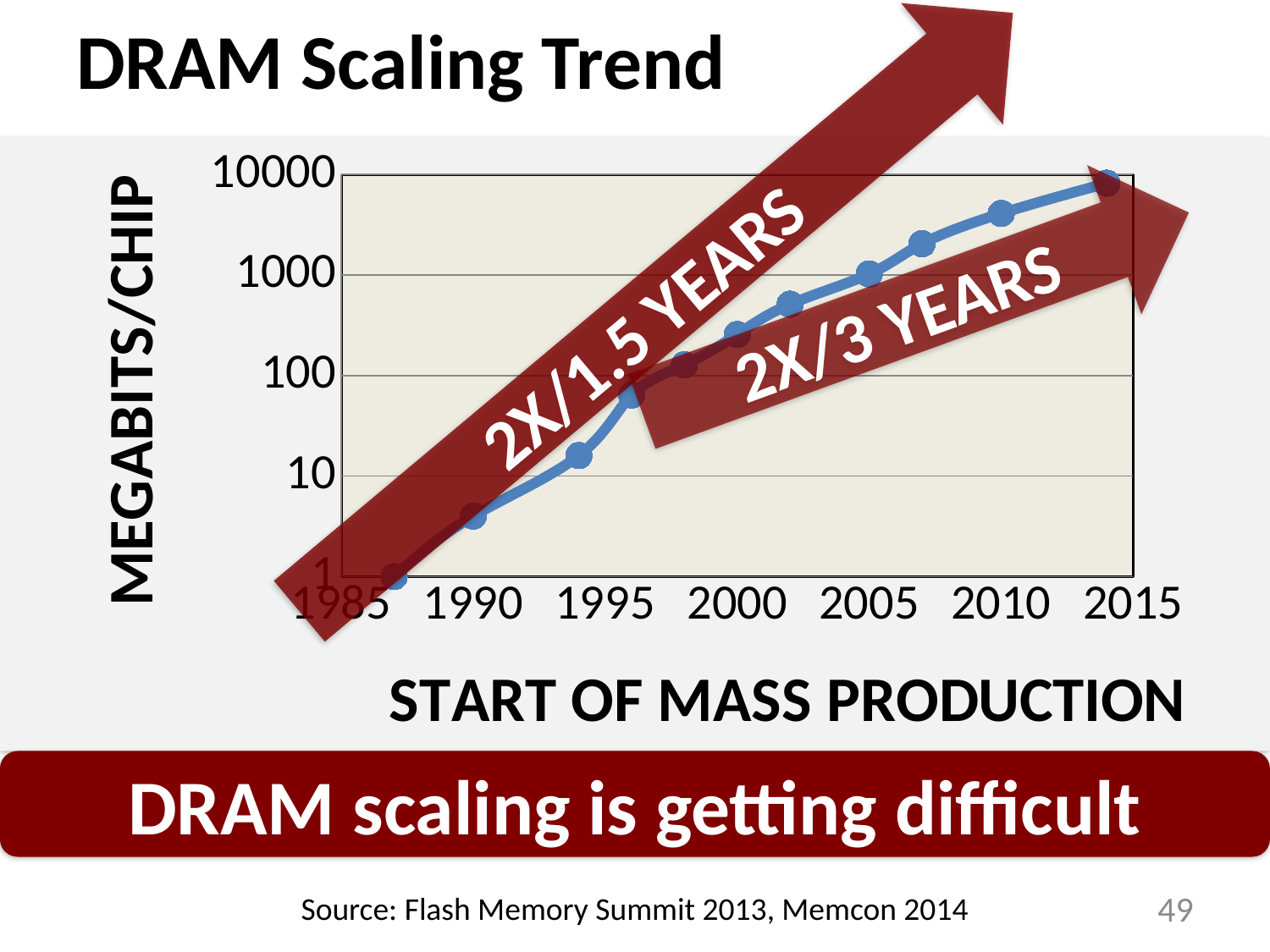
Is the value for the point at 2007 greater or less than 1000 megabits/chip? greater Is the value for the point at 1990 greater or less than 10 megabits/chip? less What is the title of the y axis? MEGABITS/CHIP Do the megabits per chip values rise or fall as the start of mass production year increases? rise Is the value for the point at 2000 greater or less than 100 megabits/chip? greater Which has the smaller megabits/chip value, the point at 2000 or the point at 1994? 1994 What two growth-rate labels are written on the arrows over the chart? 2X/1.5 YEARS and 2X/3 YEARS What kind of chart is shown on the slide? line chart Which has the larger megabits/chip value, the point at 1990 or the point at 2010? 2010